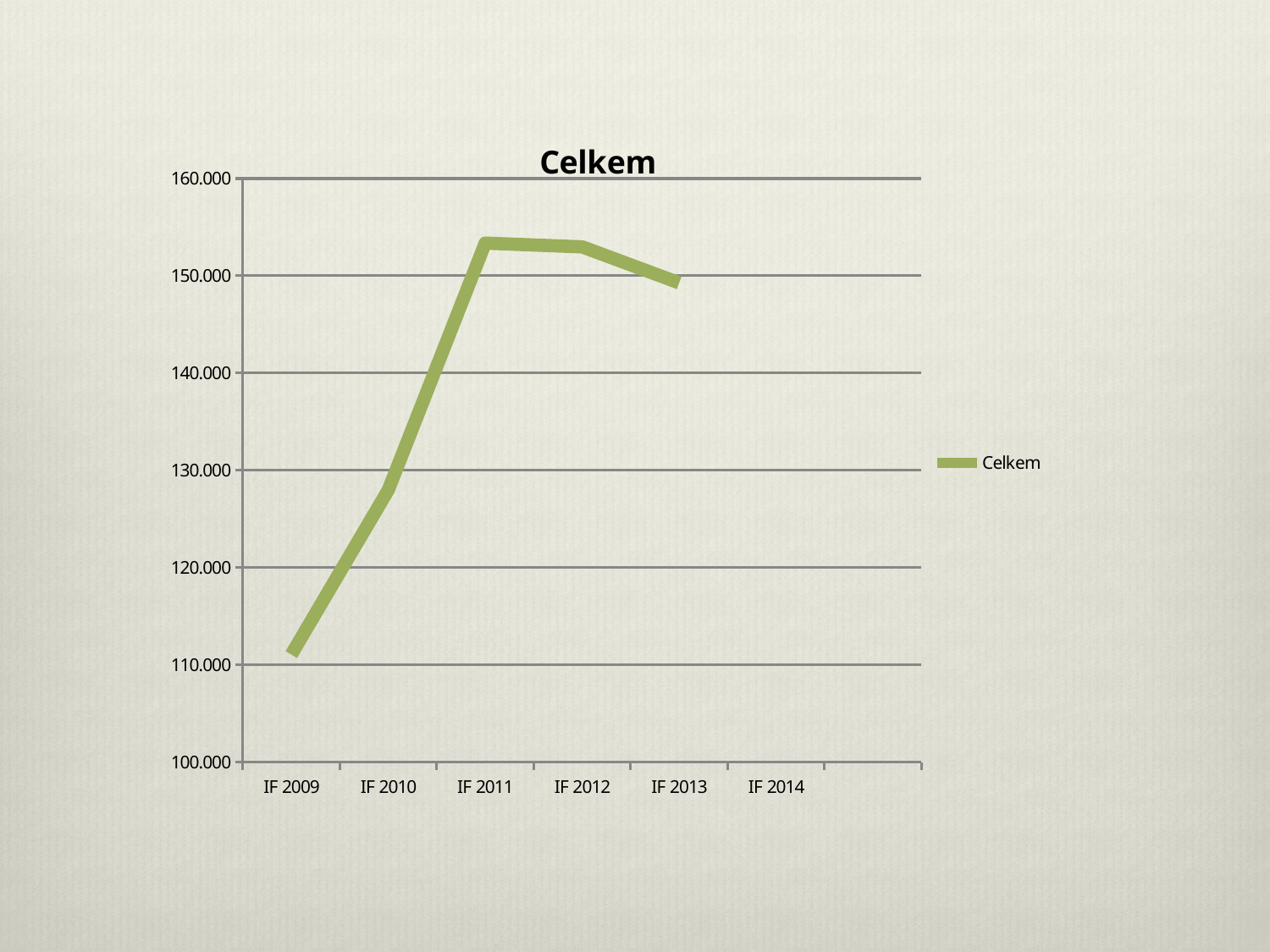
What is the title of the chart? Celkem Which is larger, the value for IF 2009 or the value for IF 2010? IF 2010 Is the value for IF 2013 greater or less than 140.000? greater How many series does the legend list? 1 Is the value for IF 2011 greater or less than 150.000? greater Is the value for IF 2009 greater or less than 120.000? less What kind of chart is shown on the slide? line chart How many categories are labelled on the x axis? 6 Which category has the lowest value on the line? IF 2009 Which is larger, the value for IF 2011 or the value for IF 2013? IF 2011 Do the values rise or fall from IF 2009 to IF 2011? rise